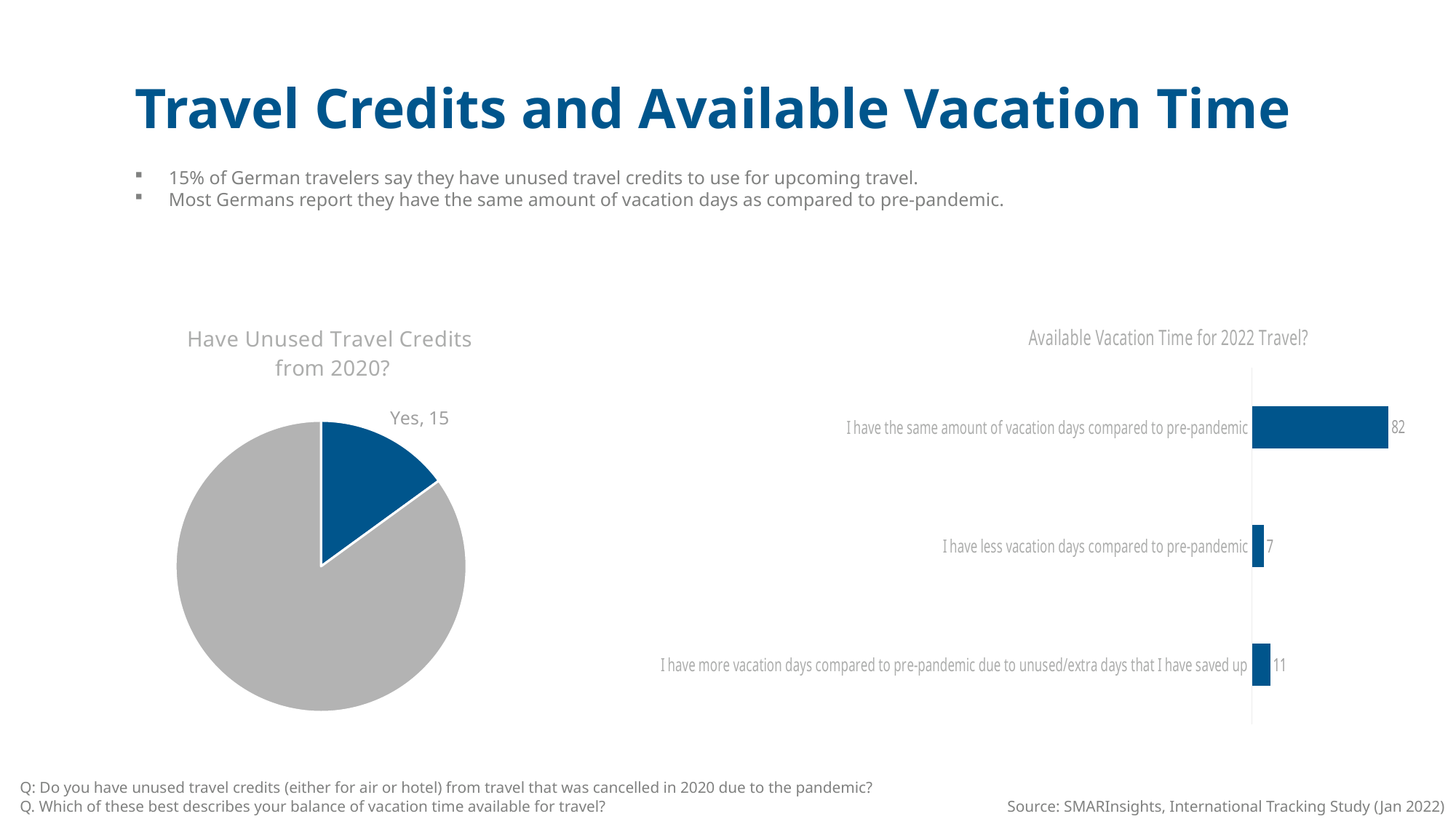
In the 'Available Vacation Time for 2022 Travel?' chart, which category has the highest value? I have the same amount of vacation days compared to pre-pandemic In the 'Available Vacation Time for 2022 Travel?' chart, what is the value for 'I have the same amount of vacation days compared to pre-pandemic'? 82 In the 'Have Unused Travel Credits from 2020?' chart, what is the value labelled for the 'Yes' slice? 15 In the 'Have Unused Travel Credits from 2020?' chart, what colour is the 'Yes' slice? blue In the 'Available Vacation Time for 2022 Travel?' chart, what is the value for 'I have less vacation days compared to pre-pandemic'? 7 In the 'Available Vacation Time for 2022 Travel?' chart, what is the value for 'I have more vacation days compared to pre-pandemic due to unused/extra days that I have saved up'? 11 In the 'Have Unused Travel Credits from 2020?' chart, what kind of chart is shown? pie chart In the 'Have Unused Travel Credits from 2020?' chart, how many slices does the pie have? 2 In the 'Available Vacation Time for 2022 Travel?' chart, what kind of chart is shown? bar chart In the 'Available Vacation Time for 2022 Travel?' chart, what is the difference between the value for 'I have the same amount of vacation days compared to pre-pandemic' and the value for 'I have more vacation days compared to pre-pandemic due to unused/extra days that I have saved up'? 71 In the 'Available Vacation Time for 2022 Travel?' chart, which category has the lowest value? I have less vacation days compared to pre-pandemic In the 'Available Vacation Time for 2022 Travel?' chart, how many categories are shown? 3